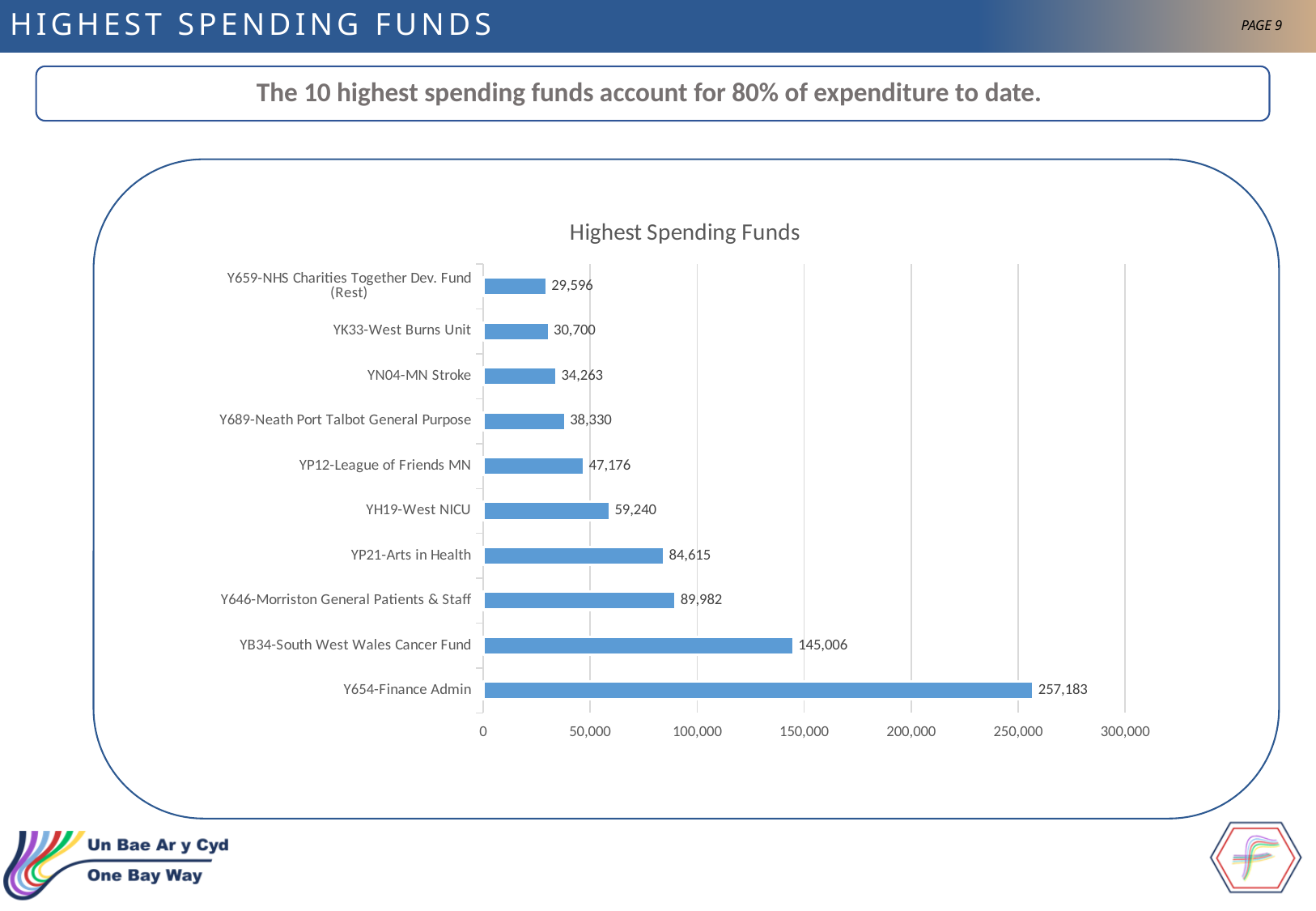
Which fund has the highest value? Y654-Finance Admin How many funds are shown in the chart? 10 What is the value for YK33-West Burns Unit? 30,700 What is the difference between Y646-Morriston General Patients & Staff and YP21-Arts in Health? 5,367 Is the value for YB34-South West Wales Cancer Fund greater or less than 150,000? less What is the difference between Y654-Finance Admin and YB34-South West Wales Cancer Fund? 112,177 What is the value for YH19-West NICU? 59,240 Which is larger, YP12-League of Friends MN or Y689-Neath Port Talbot General Purpose? YP12-League of Friends MN What is the value for YB34-South West Wales Cancer Fund? 145,006 What is the value for Y654-Finance Admin? 257,183 Which fund has the lowest value? Y659-NHS Charities Together Dev. Fund (Rest) What type of chart is shown? Bar chart